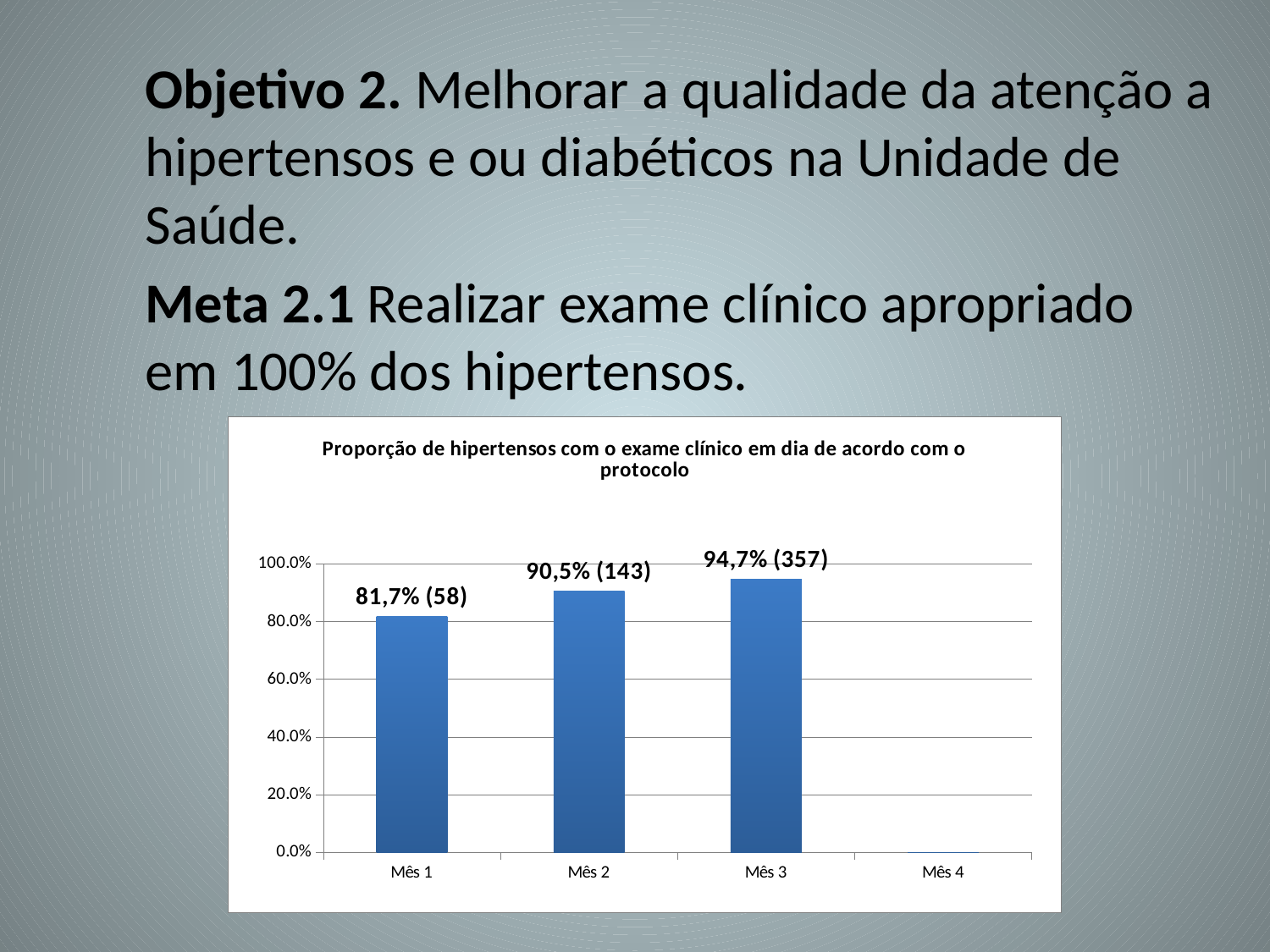
What is the value shown for Mês 1? 81,7% (58) Which month has the highest proportion? Mês 3 What is the value shown for Mês 2? 90,5% (143) What is the title of the chart? Proporção de hipertensos com o exame clínico em dia de acordo com o protocolo How many month categories are shown on the x axis? 4 Do the values rise or fall from Mês 1 to Mês 3? Rise Among the months with a bar, which has the lowest proportion? Mês 1 What type of chart is shown on the slide? Bar chart What is the difference in percentage points between Mês 3 and Mês 1? 13,0 percentage points What is the difference in percentage points between Mês 2 and Mês 1? 8,8 percentage points What is the value shown for Mês 3? 94,7% (357) Which is larger, the proportion for Mês 2 or for Mês 3? Mês 3